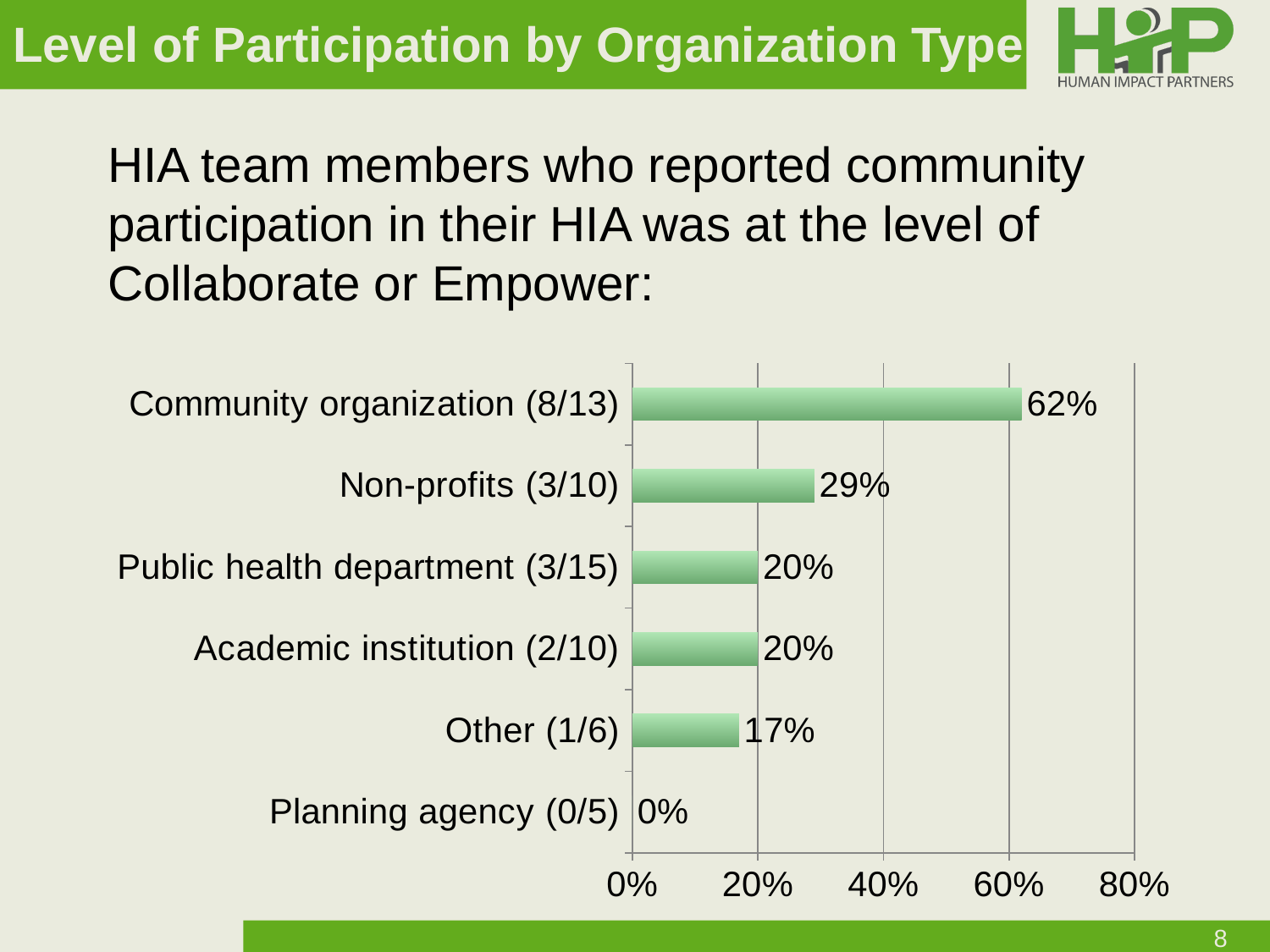
Is the value for Community organization (8/13) greater or less than 40%? greater What percentage is shown for Community organization (8/13)? 62% What is the difference in percentage points between Community organization (8/13) and Non-profits (3/10)? 33 What percentage is shown for Other (1/6)? 17% What percentage is shown for Planning agency (0/5)? 0% Which organization type has the highest percentage? Community organization (8/13) What kind of chart is shown on the slide? Bar chart How many organization types are shown in the chart? 6 What is the highest value labelled on the x axis of the chart? 80% What percentage is shown for Non-profits (3/10)? 29% Which organization type has the lowest percentage? Planning agency (0/5) Which is larger, the value for Non-profits (3/10) or the value for Public health department (3/15)? Non-profits (3/10)